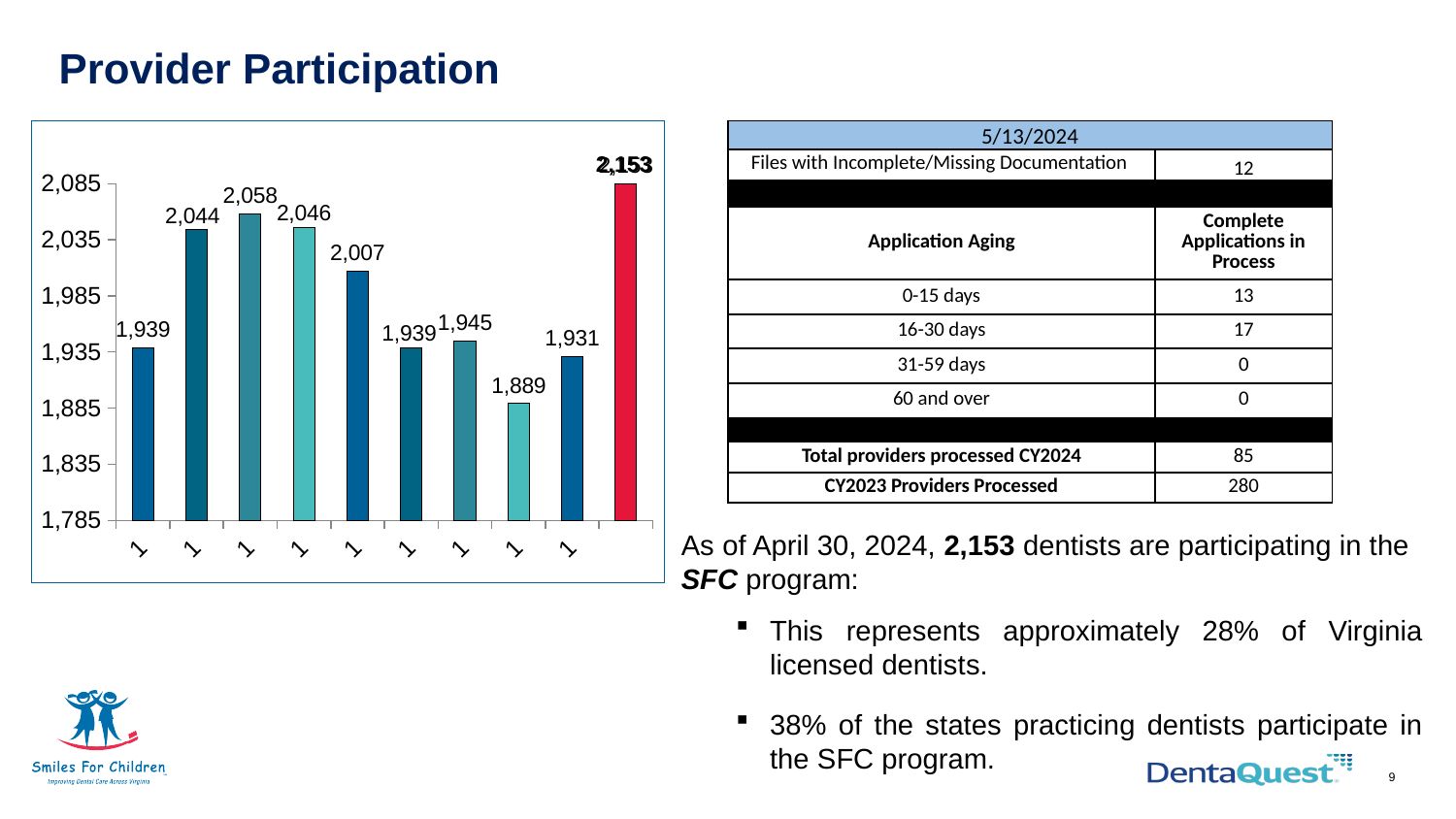
What is the difference between the highest bar (2,153) and the lowest bar (1,889) in the chart? 264 What is the value of the first (leftmost) bar in the chart? 1,939 What is the value of the last (rightmost, red) bar in the chart? 2,153 Is the value of the fifth bar from the left greater or less than 1,985? greater What is the title of the slide containing the chart? Provider Participation What type of chart is shown on the slide? bar chart What is the lowest value shown in the chart? 1,889 Which is larger in the chart: the second bar from the left or the third bar from the left? the third bar (2,058) What is the value of the third bar from the left in the chart? 2,058 How many bars are plotted in the chart? 10 What is the difference between the last bar (2,153) and the first bar (1,939) in the chart? 214 What is the highest value shown in the chart? 2,153